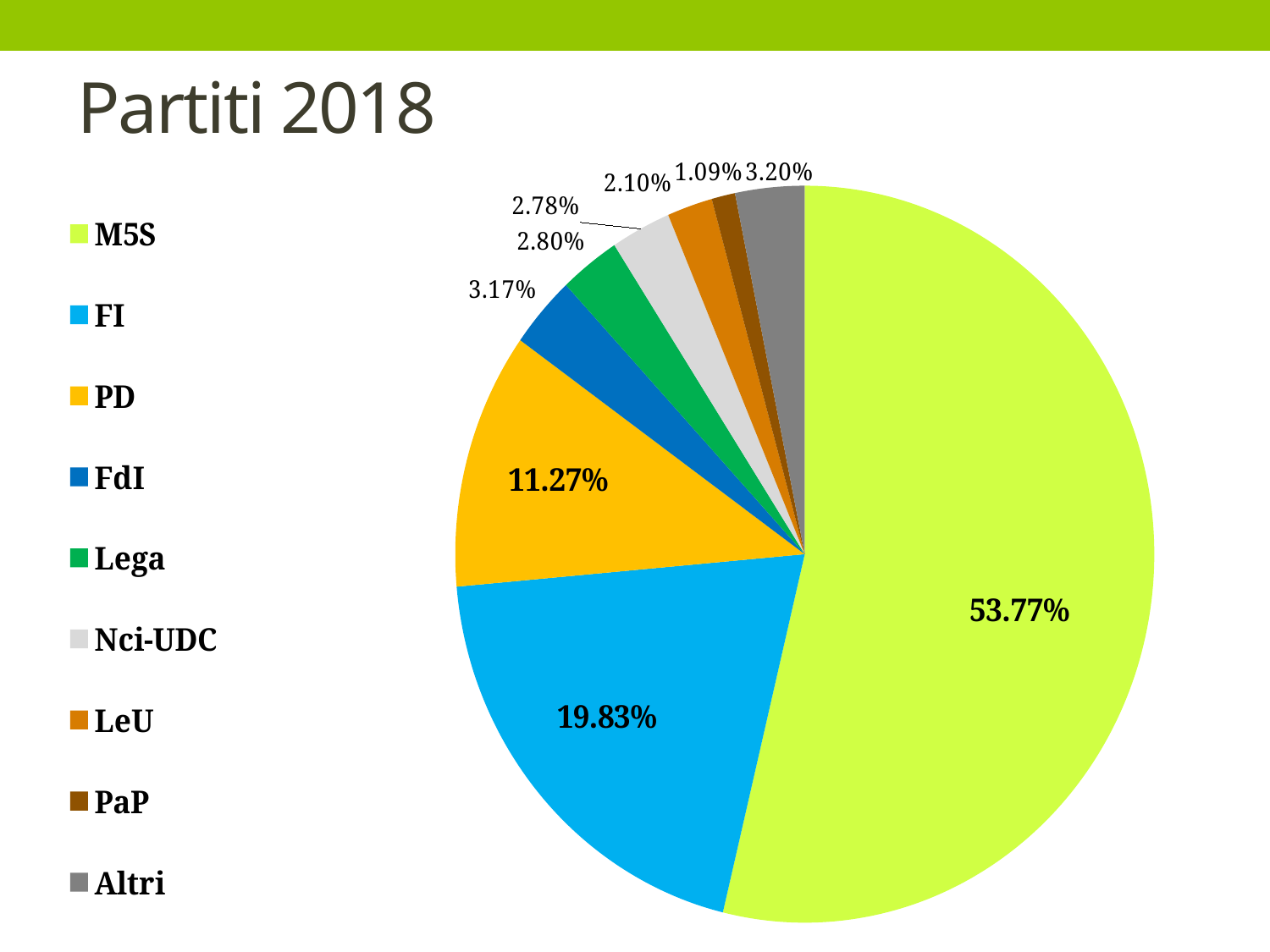
Which party has the largest slice of the pie? M5S What is the title of the chart? Partiti 2018 What is the difference between the M5S and FI percentages? 33.94% What percentage does the PD slice show? 11.27% What percentage does the M5S slice show? 53.77% What kind of chart is shown on the slide? pie chart What percentage does the Altri slice show? 3.20% What percentage does the FI slice show? 19.83% Which party has the smallest slice of the pie? PaP Which is larger, the PD slice or the FdI slice? PD How many categories does the legend list? 9 What percentage does the FdI slice show? 3.17%